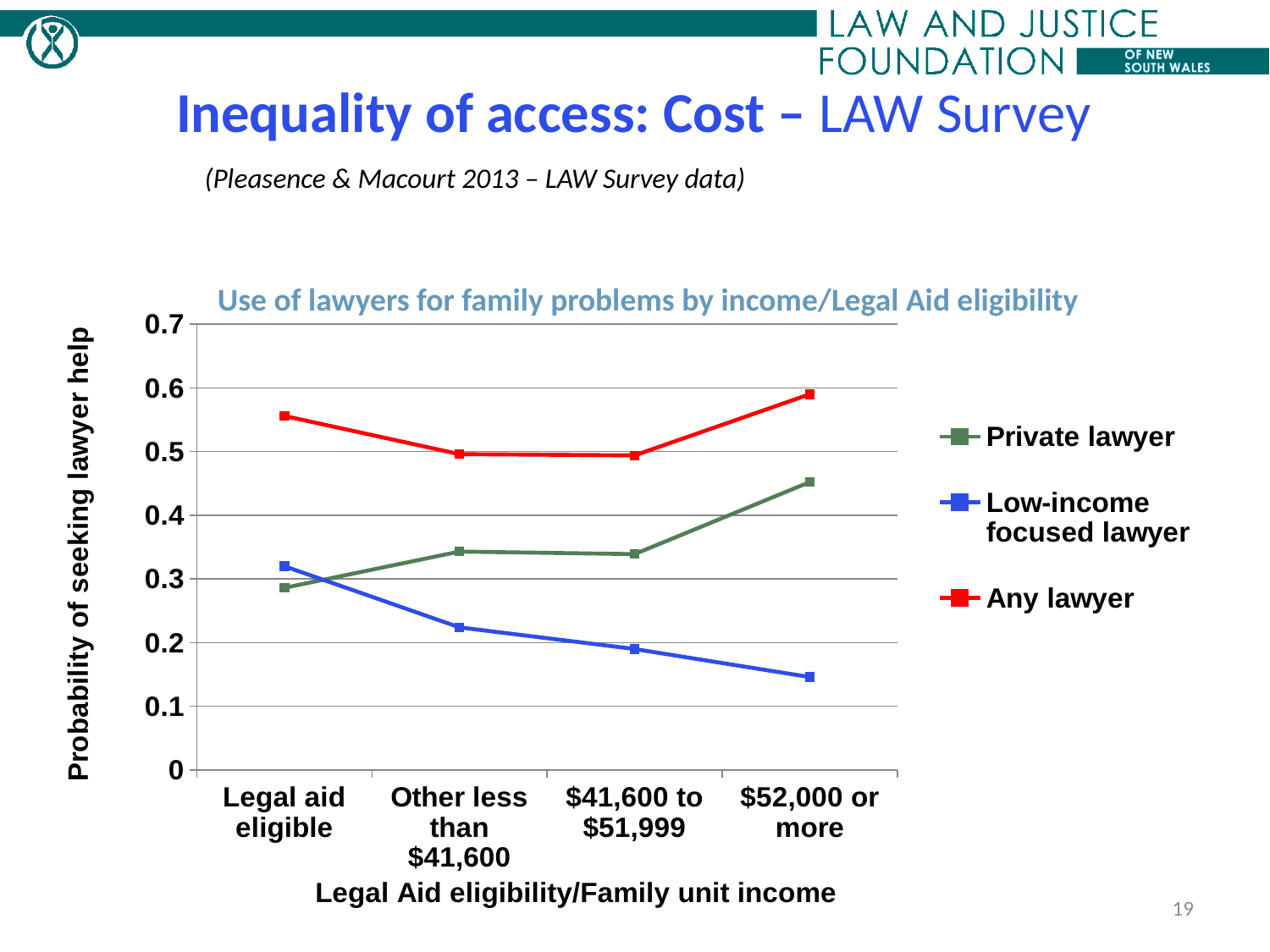
What colour is the Any lawyer line? Red Does the Low-income focused lawyer line rise or fall as income increases along the x axis? Falls How many income/eligibility categories are shown on the x axis? 4 What is the title of the chart? Use of lawyers for family problems by income/Legal Aid eligibility What kind of chart is shown on the slide? Line chart For which income category is the Any lawyer probability highest? $52,000 or more Is the value for Private lawyer in the $52,000 or more category greater or less than 0.4? greater For which income category is the Low-income focused lawyer probability lowest? $52,000 or more How many series does the legend list? 3 Is the value for Any lawyer in the Legal aid eligible category greater or less than 0.5? greater In the Legal aid eligible category, which is higher: Private lawyer or Low-income focused lawyer? Low-income focused lawyer Is the value for Low-income focused lawyer in the $52,000 or more category greater or less than 0.2? less